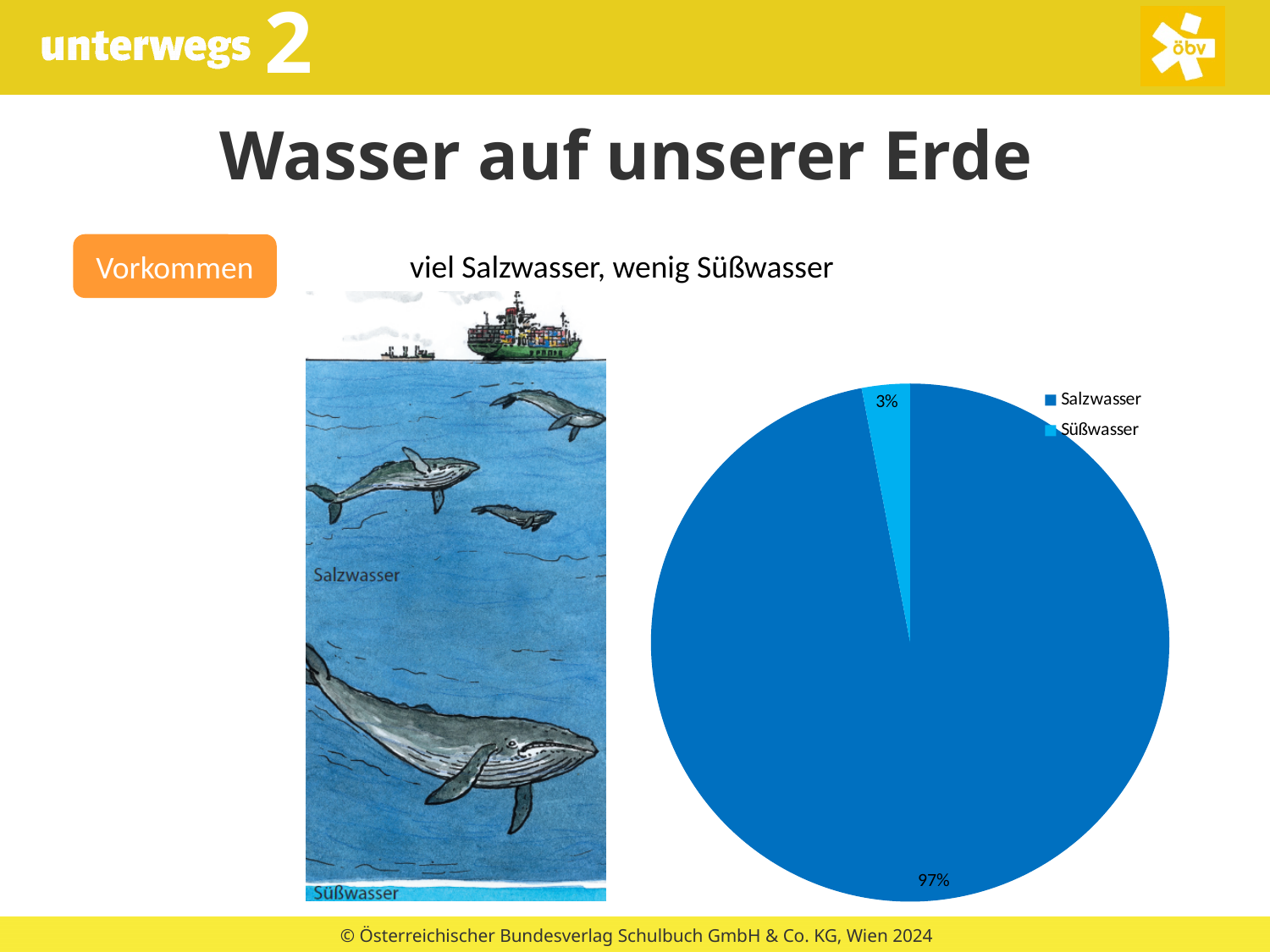
Which is larger, the slice for Salzwasser or the slice for Süßwasser? Salzwasser Which category has the largest slice of the pie? Salzwasser What are the two legend entries of the pie chart? Salzwasser, Süßwasser What kind of chart is shown on the slide? pie chart What share of the pie does Süßwasser have? 3% What is the title of the slide containing the pie chart? Wasser auf unserer Erde Which category has the smallest slice of the pie? Süßwasser What is the difference in percentage points between Salzwasser and Süßwasser? 94 How many entries does the legend list? 2 What share of the pie does Salzwasser have? 97% How many categories does the pie chart show? 2